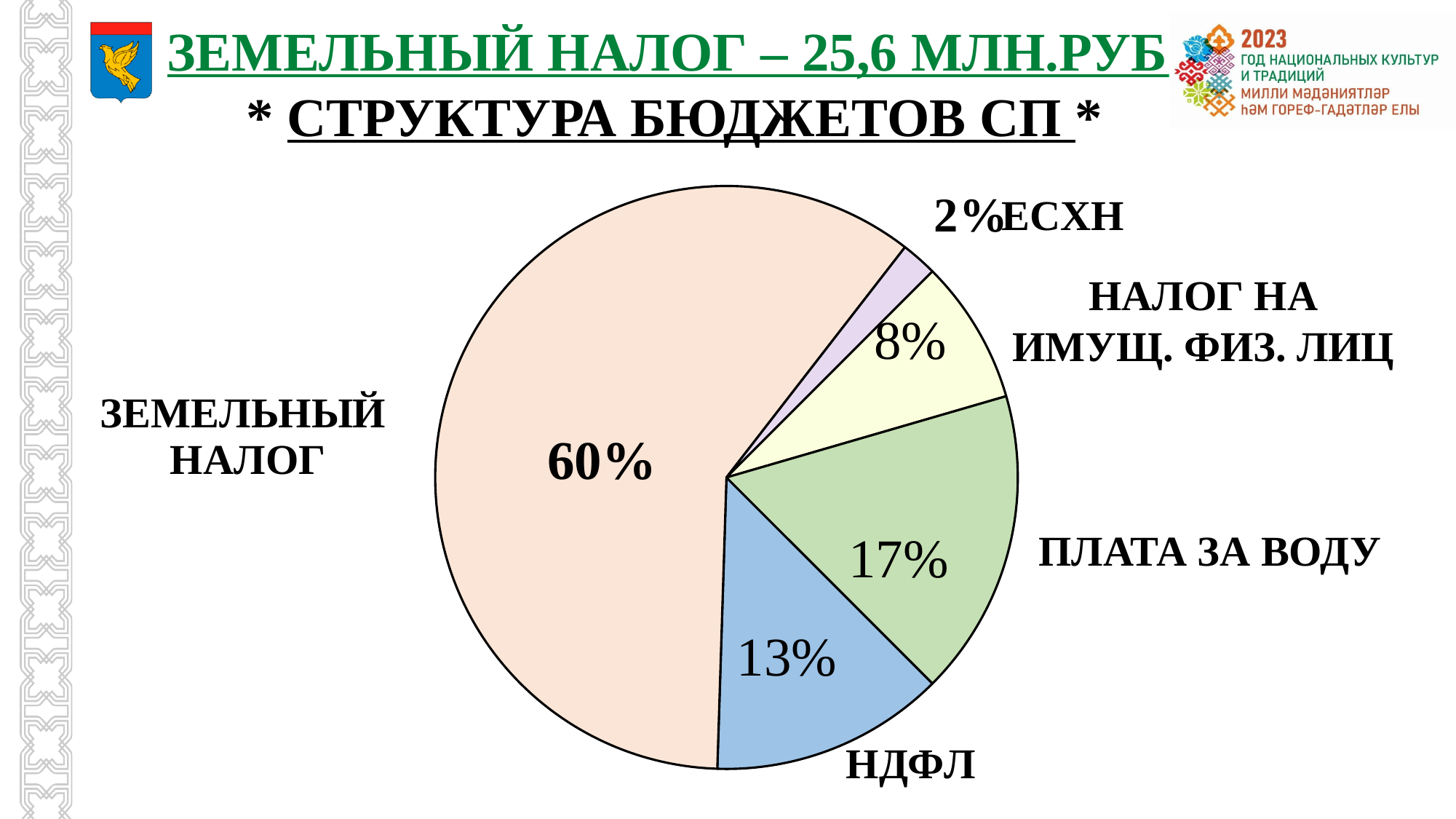
Which is larger, the share for НДФЛ or the share for НАЛОГ НА ИМУЩ. ФИЗ. ЛИЦ? НДФЛ Which slice of the pie is the largest? ЗЕМЕЛЬНЫЙ НАЛОГ What share of the pie does ЗЕМЕЛЬНЫЙ НАЛОГ have? 60% What share of the pie does НАЛОГ НА ИМУЩ. ФИЗ. ЛИЦ have? 8% Which slice of the pie is the smallest? ЕСХН What share of the pie does НДФЛ have? 13% What is the title of the chart? СТРУКТУРА БЮДЖЕТОВ СП What is the difference in percentage points between ПЛАТА ЗА ВОДУ and НДФЛ? 4 What kind of chart is shown on the slide? pie chart How many slices does the pie chart have? 5